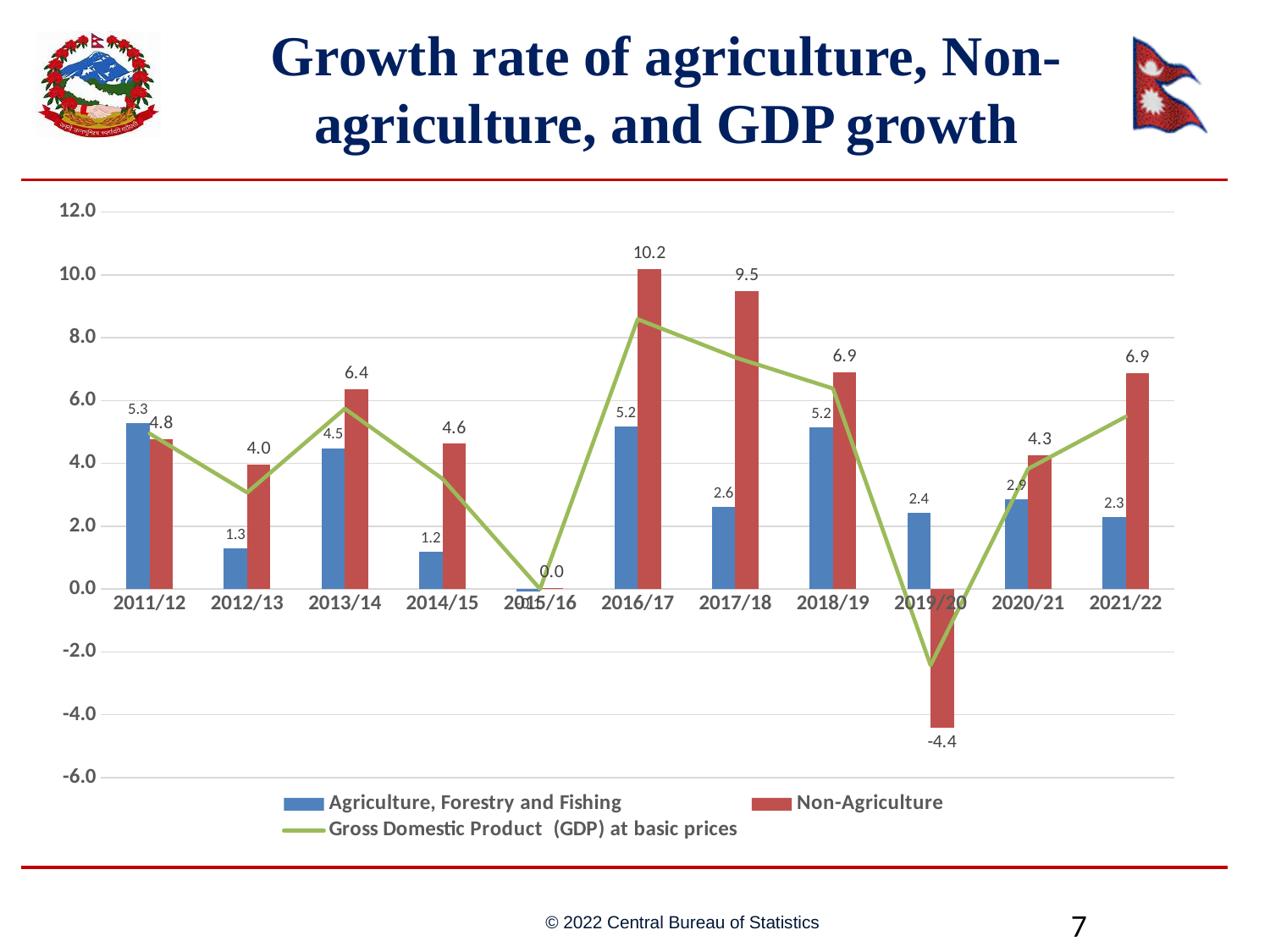
In 2021/22, how much higher is the Non-Agriculture growth rate than the Agriculture, Forestry and Fishing growth rate? 4.6 What is the Agriculture, Forestry and Fishing growth rate for 2011/12? 5.3 What is the difference between the Non-Agriculture growth rates for 2016/17 and 2017/18? 0.7 What is the Non-Agriculture growth rate for 2019/20? -4.4 How many series does the legend list? 3 In 2013/14, which is larger: the Agriculture, Forestry and Fishing growth rate or the Non-Agriculture growth rate? Non-Agriculture Is the GDP at basic prices growth rate for 2019/20 greater or less than 0.0? less In which fiscal year is the Non-Agriculture growth rate lowest? 2019/20 What is the Non-Agriculture growth rate for 2016/17? 10.2 In which fiscal year is the Non-Agriculture growth rate highest? 2016/17 How many fiscal years are shown on the x axis? 11 Is the GDP at basic prices growth rate for 2016/17 greater or less than 8.0? greater